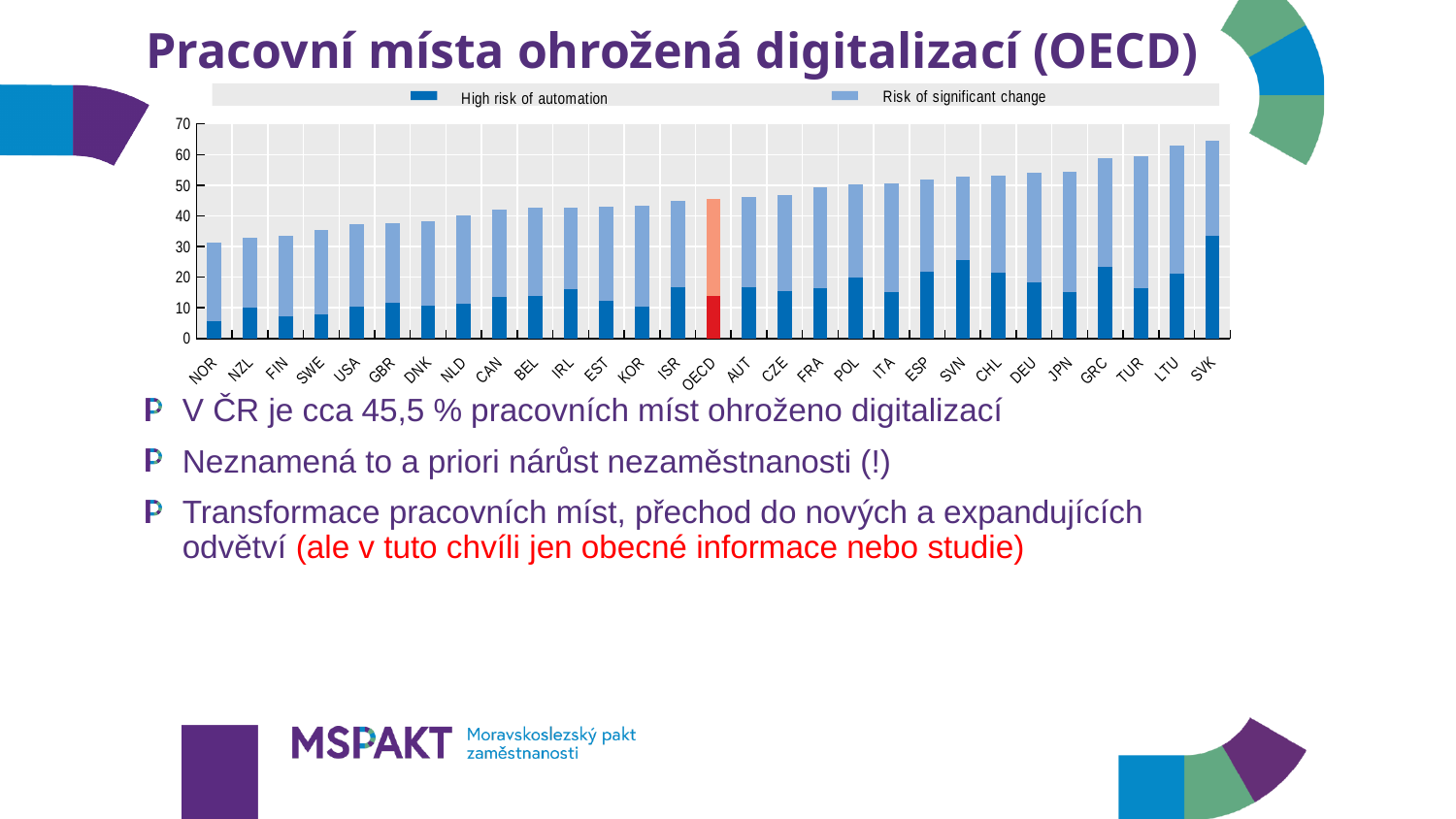
How many countries/categories are plotted along the x axis? 29 Which category's bar is highlighted in red/orange instead of blue? OECD How many series does the chart legend list? 2 Is the total value for SVK greater or less than 60? greater Which category has the highest total bar? SVK Which category has the largest 'High risk of automation' segment? SVK Which category has the lowest total bar? NOR Is the total value for CZE greater or less than 50? less Is the 'High risk of automation' value for NOR greater or less than 10? less Which has the larger 'High risk of automation' segment, SVK or SVN? SVK Do the total bar values rise or fall moving from left to right along the x axis? rise What kind of chart is shown on the slide? stacked bar chart